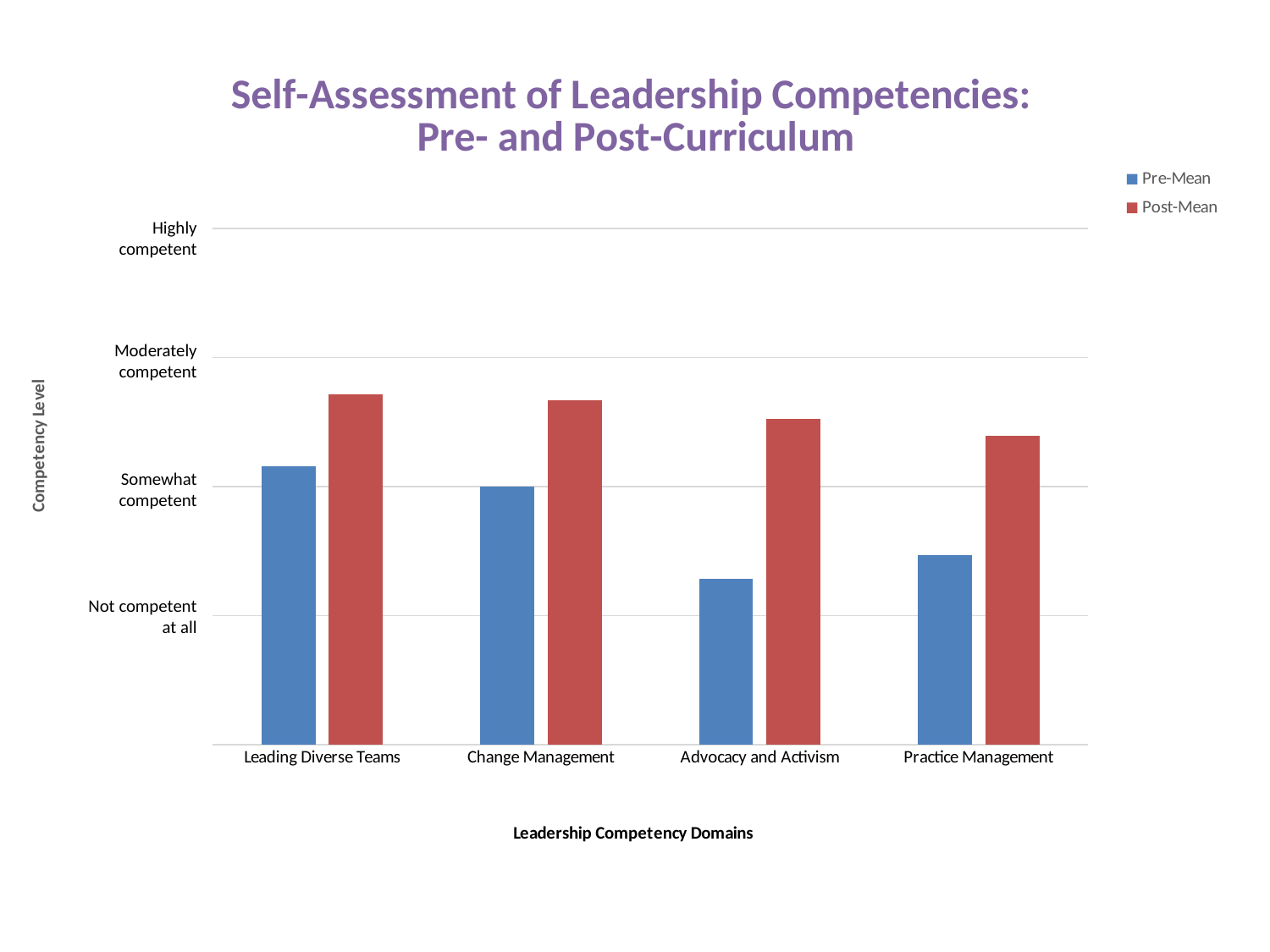
What is the title of the chart? Self-Assessment of Leadership Competencies: Pre- and Post-Curriculum Is the Post-Mean for Leading Diverse Teams above or below the 'Moderately competent' level on the y axis? below How many leadership competency domains are shown on the x axis? 4 Which domain has the lowest Post-Mean bar? Practice Management Which domain has the highest Pre-Mean bar? Leading Diverse Teams How many series does the legend list? 2 Which domain has the lowest Pre-Mean bar? Advocacy and Activism For Advocacy and Activism, which is larger, the Pre-Mean or the Post-Mean? Post-Mean Which is larger, the Pre-Mean for Change Management or the Pre-Mean for Practice Management? Change Management What is the label of the x axis? Leadership Competency Domains Is the Pre-Mean for Advocacy and Activism above or below the 'Somewhat competent' level on the y axis? below What type of chart is shown on the slide? Bar chart